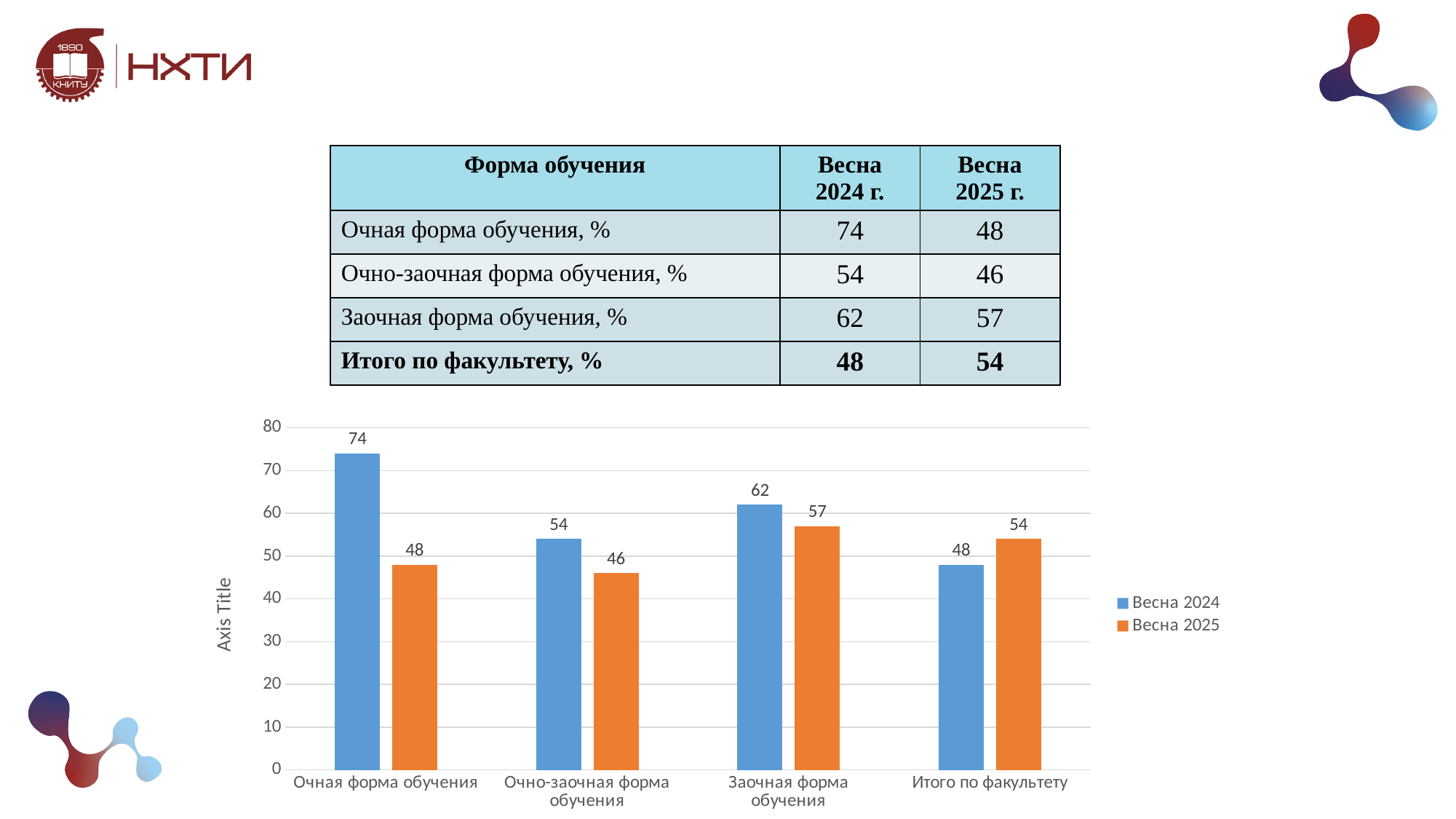
What is the value for Итого по факультету in the Весна 2025 series? 54 How many series does the chart legend list? 2 Which category has the highest value in the Весна 2024 series? Очная форма обучения Is the Весна 2024 value for Заочная форма обучения greater or less than 60? greater What is the value for Очная форма обучения in the Весна 2024 series? 74 What colour are the Весна 2025 bars in the chart? orange What is the value for Заочная форма обучения in the Весна 2025 series? 57 What is the difference between the Весна 2024 and Весна 2025 values for Очная форма обучения? 26 What kind of chart is shown on the slide? bar chart How many categories are shown on the x axis of the chart? 4 Which category has the lowest value in the Весна 2025 series? Очно-заочная форма обучения For Итого по факультету, which series has the larger value, Весна 2024 or Весна 2025? Весна 2025